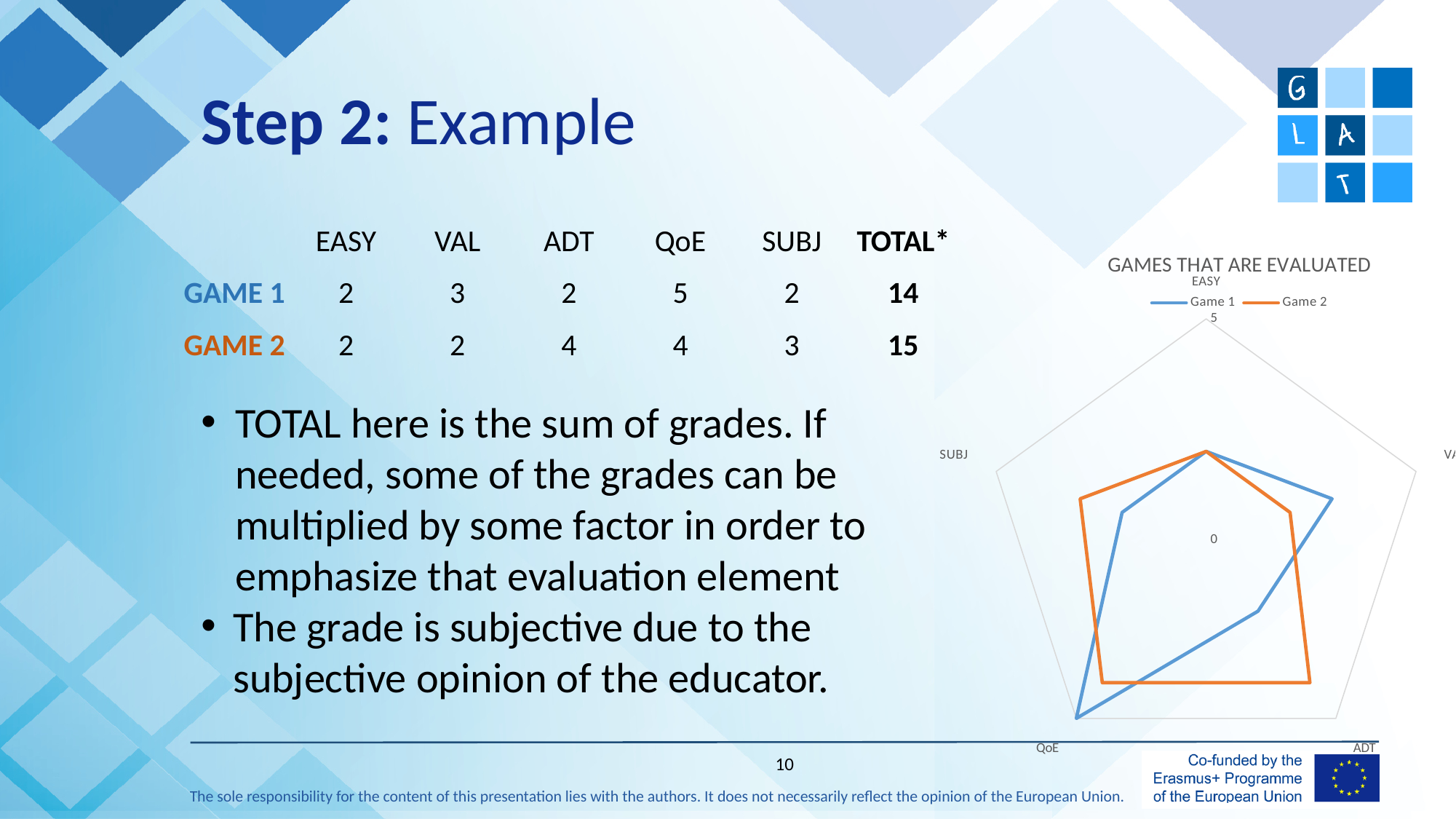
On the QoE axis, which series has the larger value, Game 1 or Game 2? Game 1 Which series are listed in the chart's legend? Game 1 and Game 2 How many axes (categories) does the radar chart have? 5 How many series does the chart's legend list? 2 On which axis does Game 1 reach its highest value? QoE What is the value for Game 2 on the ADT axis of the chart? 4 What kind of chart is shown on the slide? Radar chart What is the difference between Game 1 and Game 2 on the QoE axis? 1 Is the value for Game 1 on the ADT axis greater or less than 5? less What is the title of the chart on the slide? GAMES THAT ARE EVALUATED What is the value for Game 1 on the QoE axis of the chart? 5 On the ADT axis, which series has the larger value, Game 1 or Game 2? Game 2